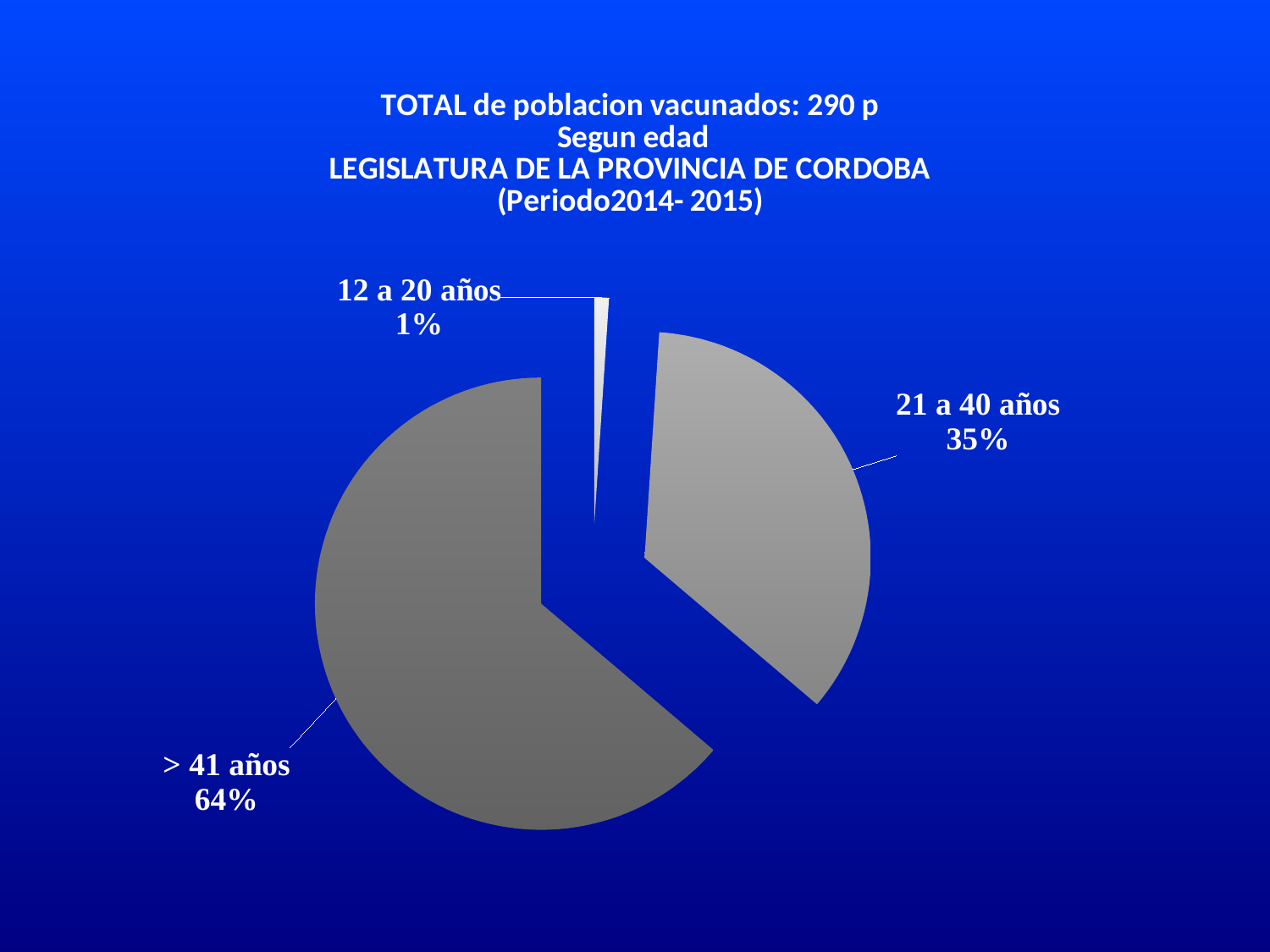
Which age group has the smallest share of the pie? 12 a 20 años What percentage of the vaccinated population is in the "21 a 40 años" group? 35% How many age groups are shown in the pie chart? 3 What is the difference in percentage points between the "> 41 años" and "21 a 40 años" slices? 29 Which age group has the largest share of the pie? > 41 años What is the total vaccinated population stated in the chart title? 290 p What percentage of the vaccinated population is in the "12 a 20 años" group? 1% What percentage of the vaccinated population is in the "> 41 años" group? 64% What type of chart is shown on the slide? pie chart What is the combined share of the "21 a 40 años" and "12 a 20 años" slices? 36% What period does the chart title say the data covers? 2014- 2015 Which slice is larger, "21 a 40 años" or "12 a 20 años"? 21 a 40 años